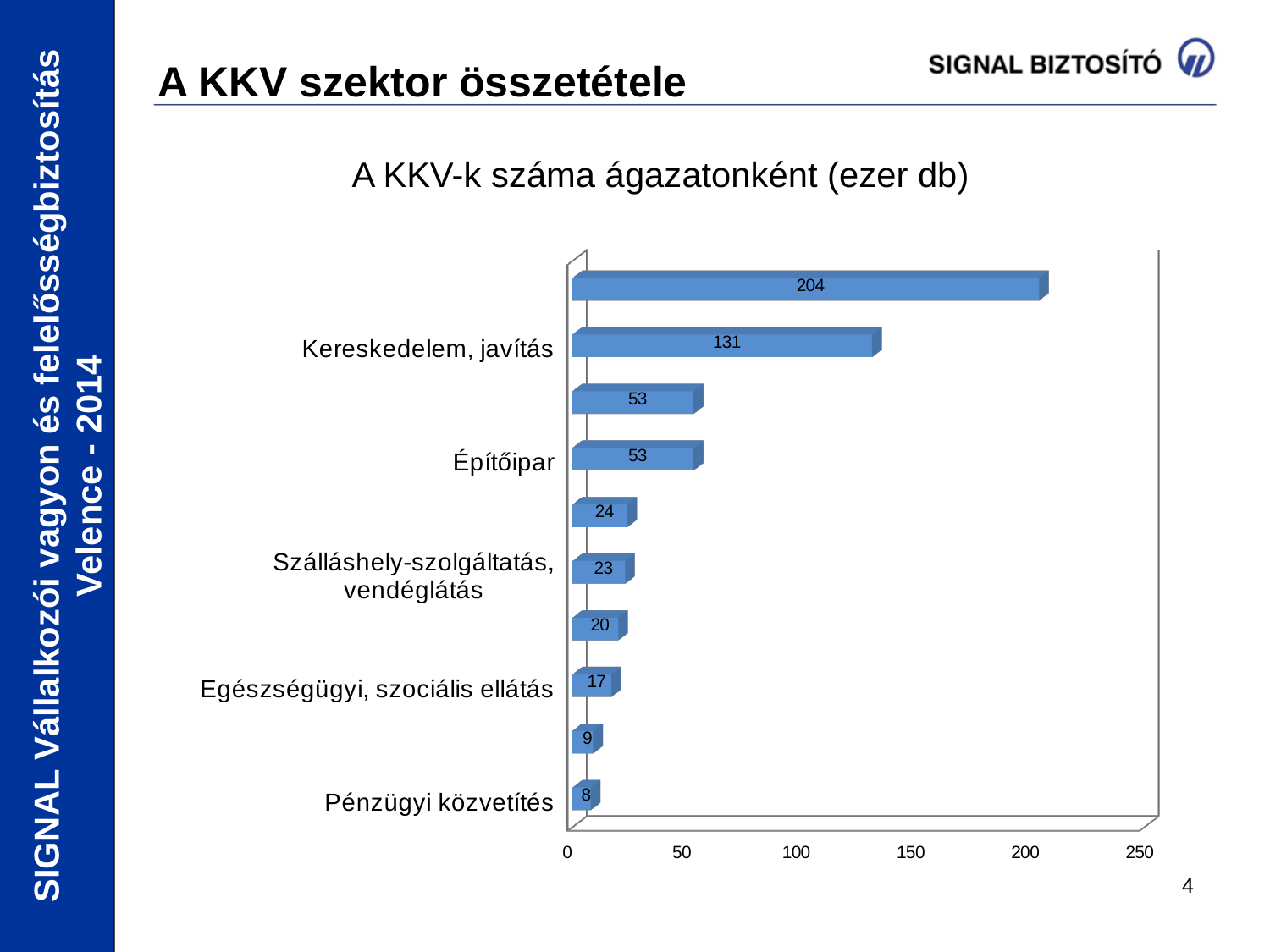
Which labelled category has the lowest value? Pénzügyi közvetítés What is the value for Kereskedelem, javítás? 131 What type of chart is shown on the slide? bar chart What is the largest value shown on the chart? 204 What is the title of the chart? A KKV-k száma ágazatonként (ezer db) What is the difference between the values for Kereskedelem, javítás and Építőipar? 78 Which is larger, the value for Szálláshely-szolgáltatás, vendéglátás or the value for Egészségügyi, szociális ellátás? Szálláshely-szolgáltatás, vendéglátás What is the value for Építőipar? 53 How many bars are plotted on the chart? 10 What is the value for Egészségügyi, szociális ellátás? 17 What is the value for Pénzügyi közvetítés? 8 What is the value for Szálláshely-szolgáltatás, vendéglátás? 23